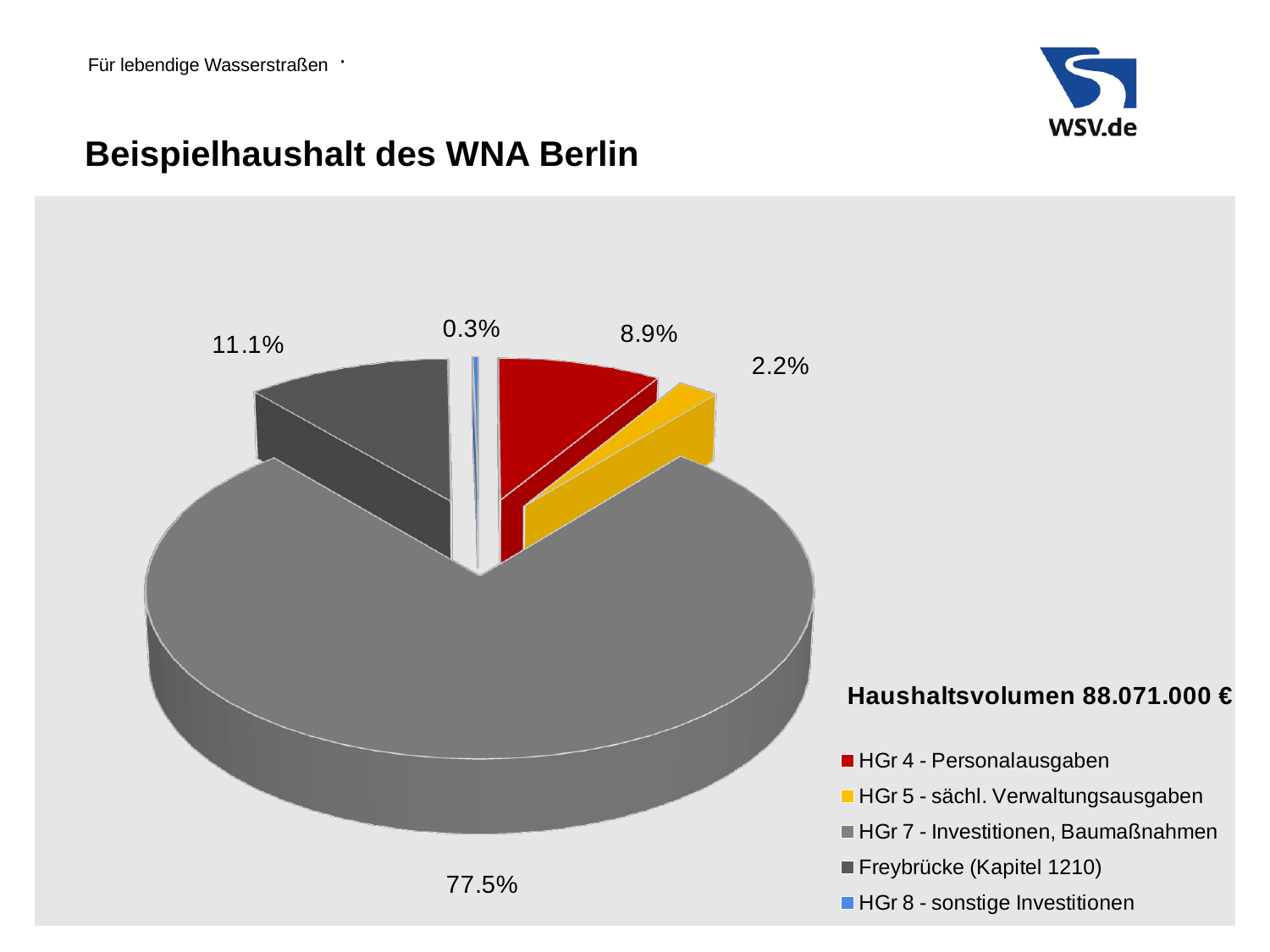
What Haushaltsvolumen is stated next to the chart? 88.071.000 € What share of the pie does HGr 4 - Personalausgaben have? 8.9% What share of the pie does HGr 7 - Investitionen, Baumaßnahmen have? 77.5% What is the difference in percentage points between the shares of Freybrücke (Kapitel 1210) and HGr 4 - Personalausgaben? 2.2 percentage points Which category has the largest share of the pie? HGr 7 - Investitionen, Baumaßnahmen What share of the pie does HGr 5 - sächl. Verwaltungsausgaben have? 2.2% Which has the larger share: HGr 4 - Personalausgaben or Freybrücke (Kapitel 1210)? Freybrücke (Kapitel 1210) What type of chart is shown on the slide? pie chart Which category has the smallest share of the pie? HGr 8 - sonstige Investitionen How many categories does the legend list? 5